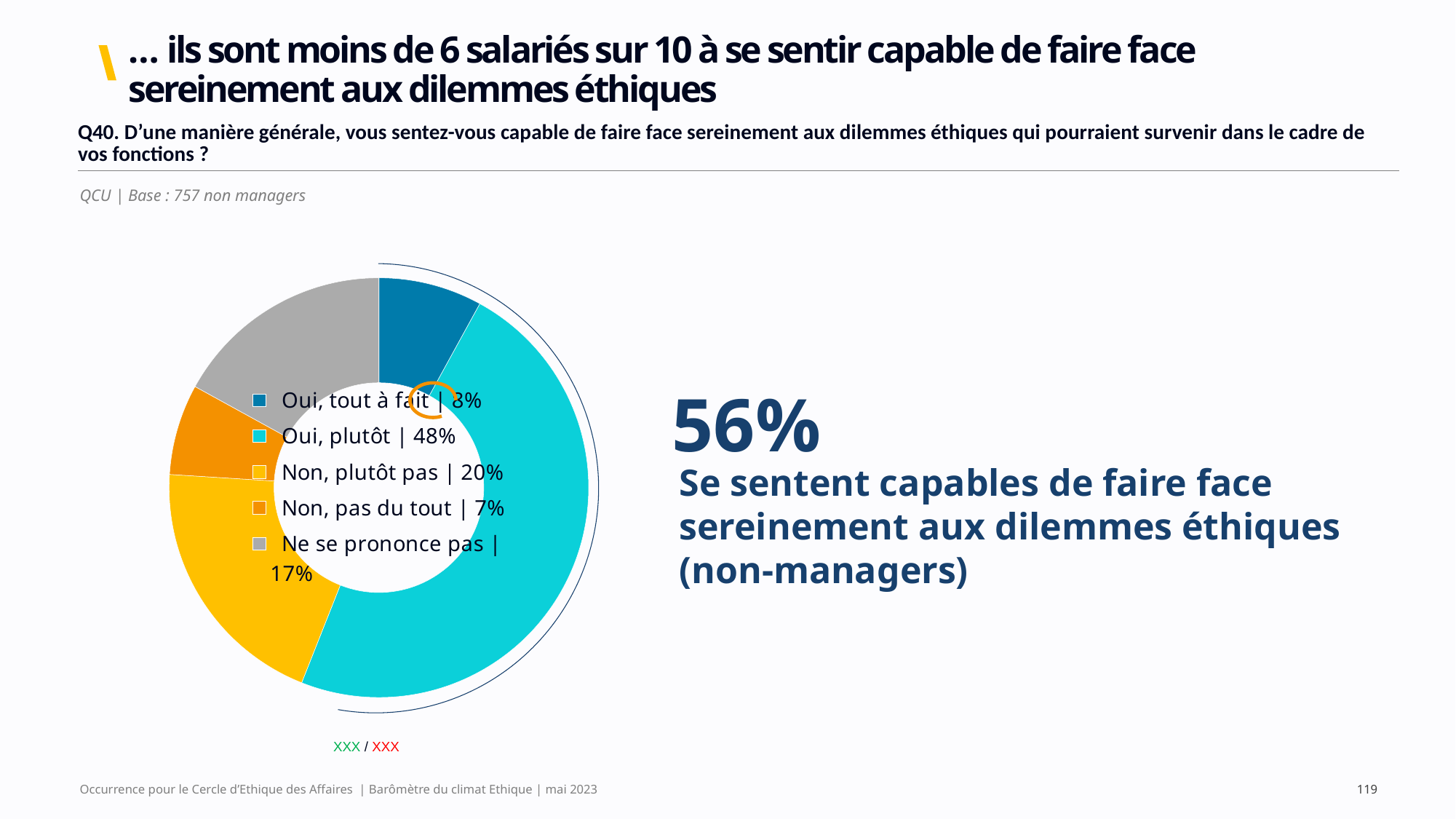
What percentage of non-managers answered "Oui, plutôt"? 48% What percentage of non-managers answered "Non, plutôt pas"? 20% What is the combined share of "Oui, tout à fait" and "Oui, plutôt"? 56% What is the difference in percentage points between "Oui, plutôt" and "Non, plutôt pas"? 28 Which is larger: the share for "Ne se prononce pas" or the share for "Non, pas du tout"? Ne se prononce pas What kind of chart is shown on the slide? Pie chart (donut) What colour is the "Oui, plutôt" slice in the pie chart? Cyan (turquoise) What percentage of non-managers answered "Non, pas du tout"? 7% How many response categories does the pie chart show? 5 Which response category has the smallest share of the pie? Non, pas du tout What percentage of non-managers answered "Ne se prononce pas"? 17% Which response category has the largest share of the pie? Oui, plutôt